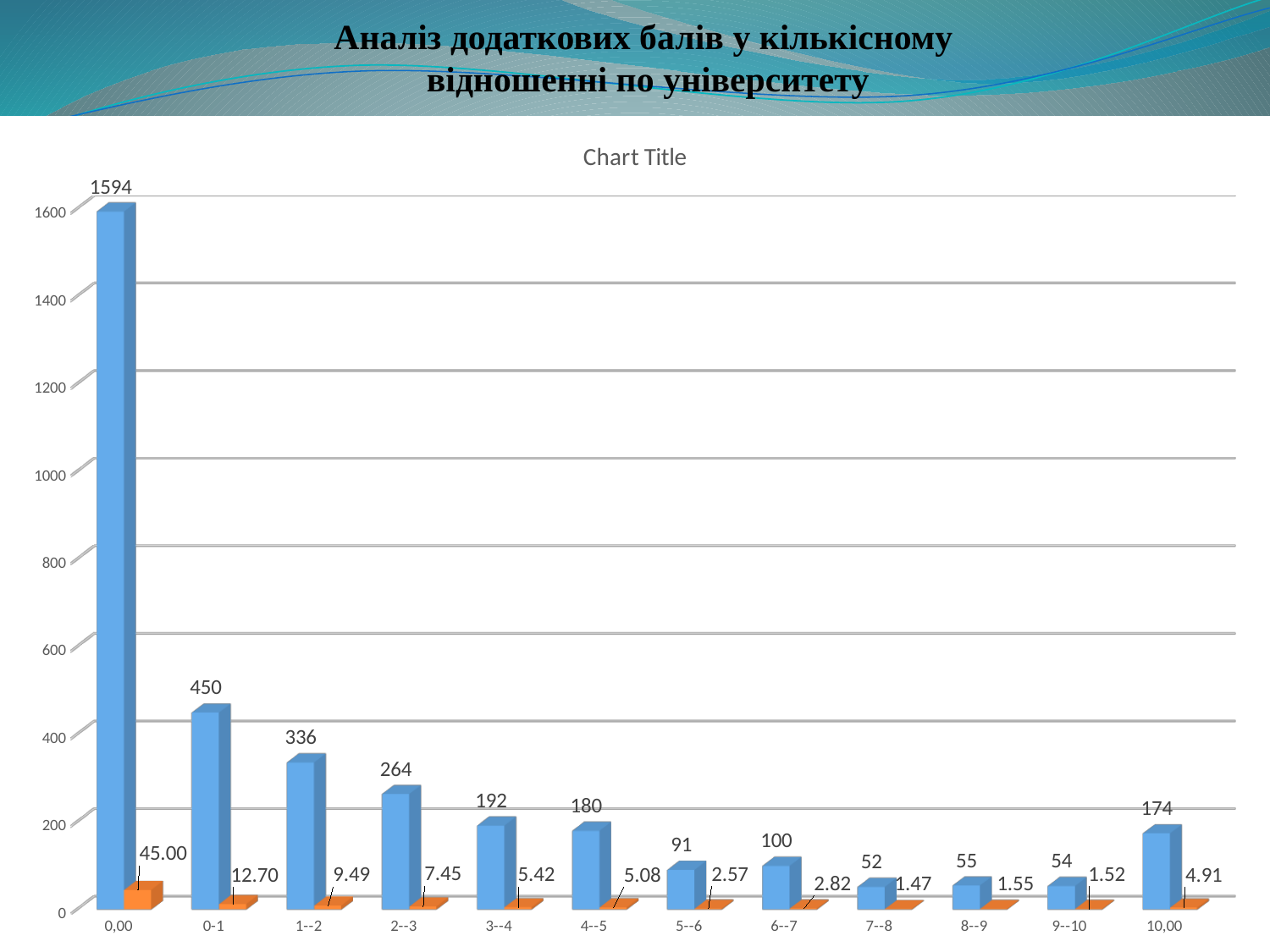
What is the value of the blue bar for the category 0,00? 1594 Which category has the highest blue bar? 0,00 What is the difference between the blue bar values for 0-1 and 1--2? 114 What is the value of the blue bar for the category 10,00? 174 Is the blue bar for 2--3 greater or less than 200? greater What kind of chart is shown on the slide? bar chart What is the value of the orange bar for the category 5--6? 2.57 Which is larger, the blue bar for 5--6 or the blue bar for 6--7? 6--7 How many categories are shown on the x axis? 12 What is the title printed above the chart area? Chart Title Which category has the lowest orange bar? 7--8 What is the value of the orange bar for the category 0-1? 12.70